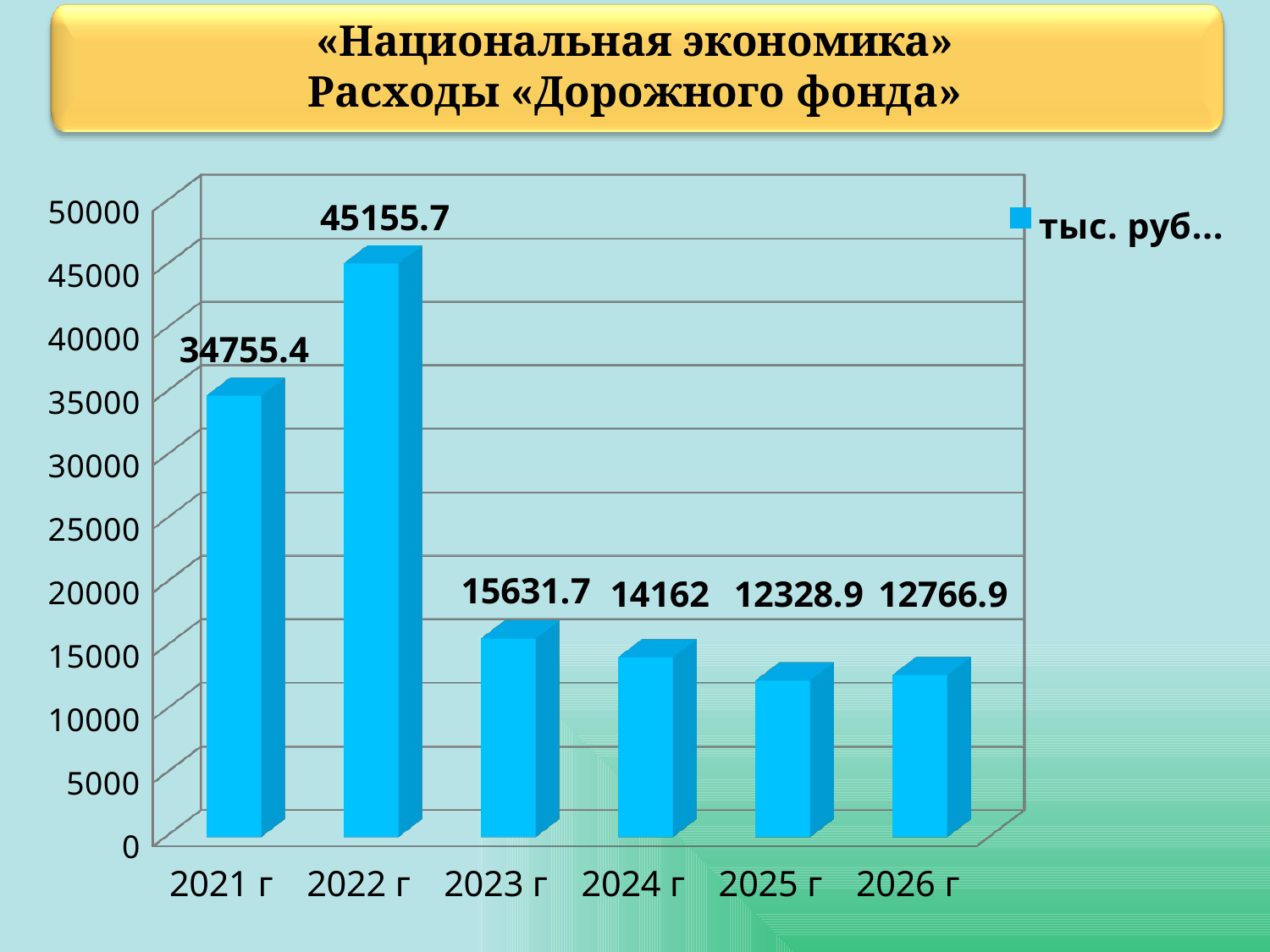
What is the difference between the values for 2022 г and 2021 г? 10400.3 Which year has the highest value? 2022 г Which year has the lowest value? 2025 г What is the value for 2021 г? 34755.4 What is the difference between the values for 2023 г and 2024 г? 1469.7 What is the value for 2024 г? 14162 What kind of chart is shown on the slide? bar chart What is the value for 2022 г? 45155.7 Which is larger, the value for 2023 г or the value for 2026 г? 2023 г Is the value for 2025 г greater or less than 15000? less How many years are shown on the x axis? 6 What is the value for 2026 г? 12766.9